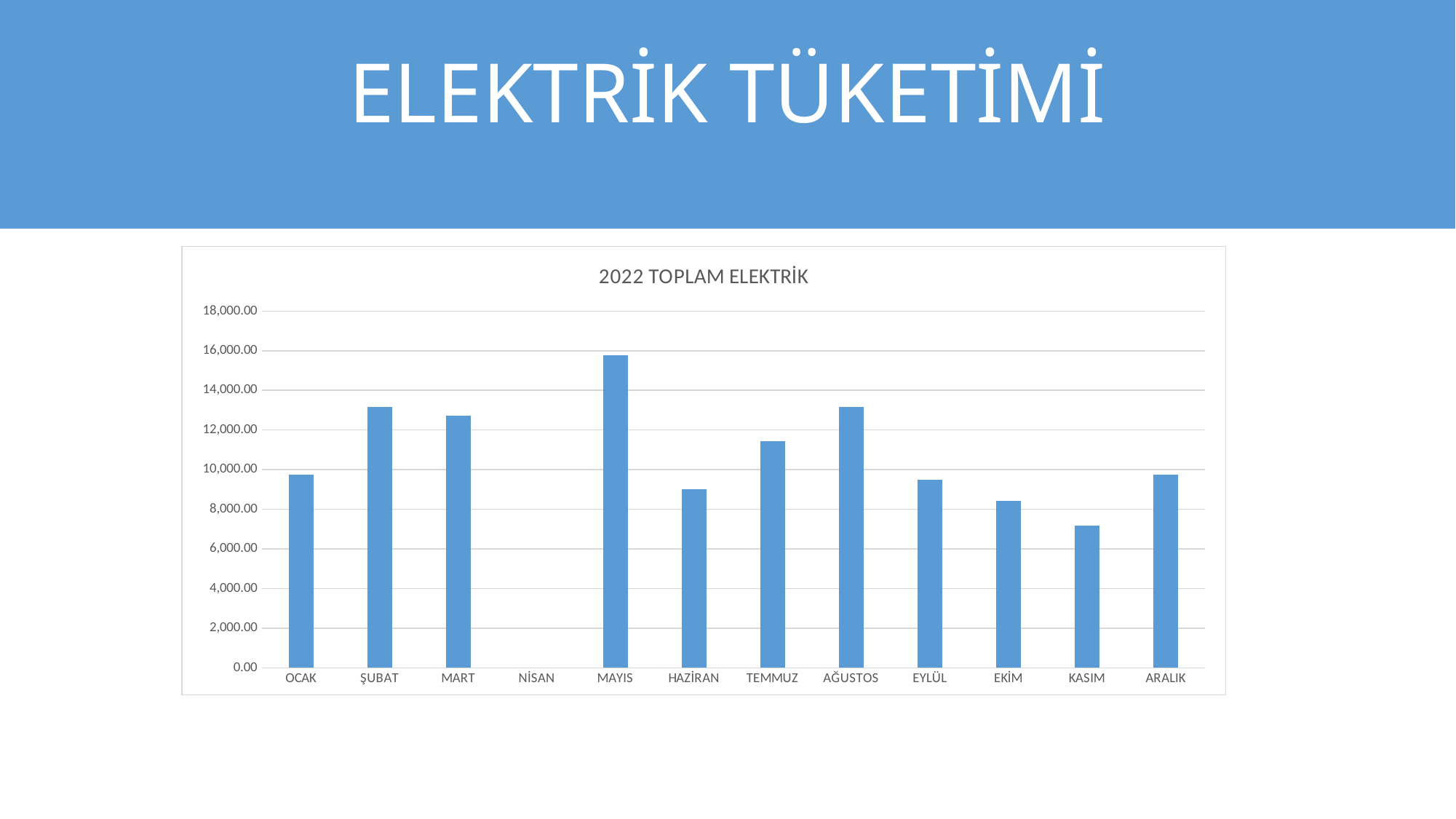
How many months are listed along the x axis of the chart? 12 What type of chart is shown on the slide? Bar chart Which month has the highest electricity value in the chart? MAYIS Is the value for MAYIS greater or less than 14,000.00? greater Which is larger, the value for MART or the value for TEMMUZ? MART Is the value for TEMMUZ greater or less than 10,000.00? greater Do the values rise or fall from AĞUSTOS through KASIM? fall Is the value for HAZİRAN greater or less than 10,000.00? less What is the title of the chart? 2022 TOPLAM ELEKTRİK Which month has no bar shown in the chart? NİSAN Among the months with a visible bar, which has the lowest value? KASIM